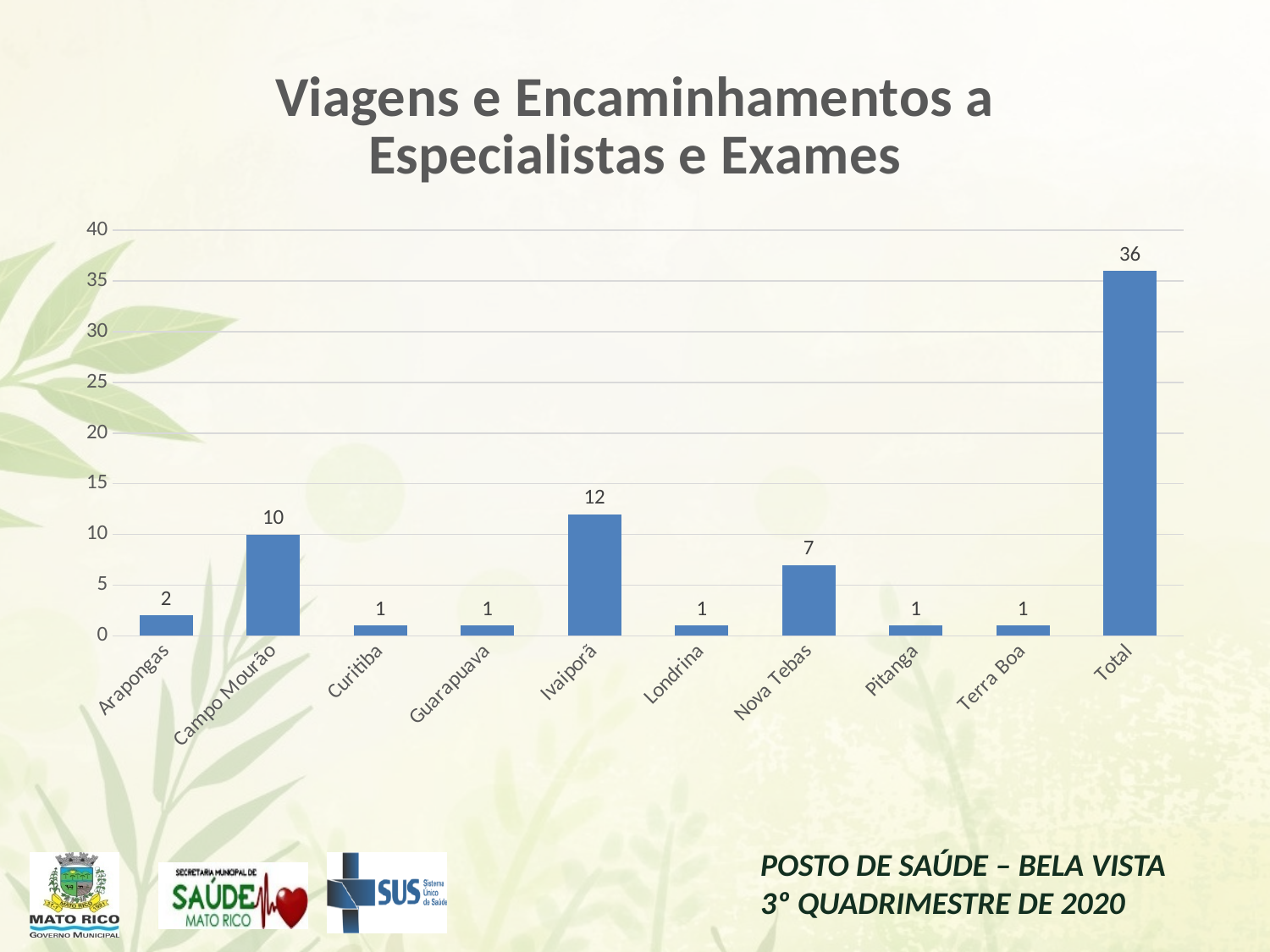
How many categories are shown on the x axis, including Total? 10 What kind of chart is shown on the slide? bar chart Which is larger, the value for Arapongas or the value for Nova Tebas? Nova Tebas Is the value for Total greater or less than 30? greater What is the difference between the values for Campo Mourão and Nova Tebas? 3 What is the value shown for Total? 36 What is the value for Nova Tebas? 7 What is the value for Campo Mourão? 10 Excluding the Total bar, which city has the highest value? Ivaiporã What is the title of the chart? Viagens e Encaminhamentos a Especialistas e Exames What is the value for Ivaiporã? 12 What is the difference between the values for Ivaiporã and Campo Mourão? 2